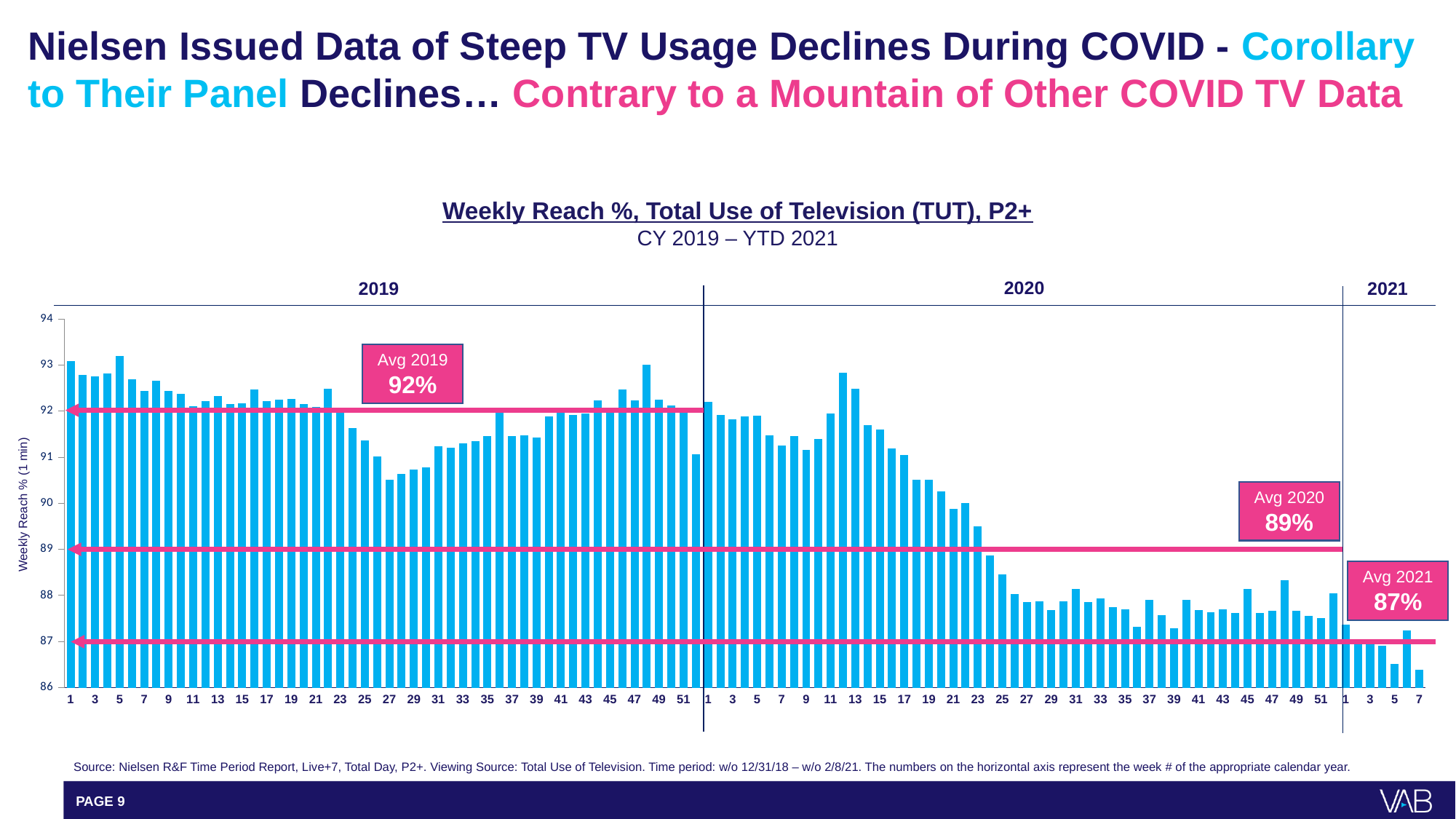
Is the value for week 27 of 2019 greater or less than 91? less Is the value for week 7 of 2021 greater or less than 87? less How many weeks of 2021 are plotted on the chart? 7 What is the average weekly reach shown for 2021? 87% Which year has the lowest average weekly reach shown on the chart? 2021 What is the average weekly reach shown for 2020? 89% Is the value for week 13 of 2020 greater or less than 92? greater What is the title of the chart? Weekly Reach %, Total Use of Television (TUT), P2+ By how many percentage points does the 2019 average exceed the 2020 average? 3 What kind of chart is shown on the slide? Bar chart What is the label on the vertical axis of the chart? Weekly Reach % (1 min) What is the average weekly reach shown for 2019? 92%